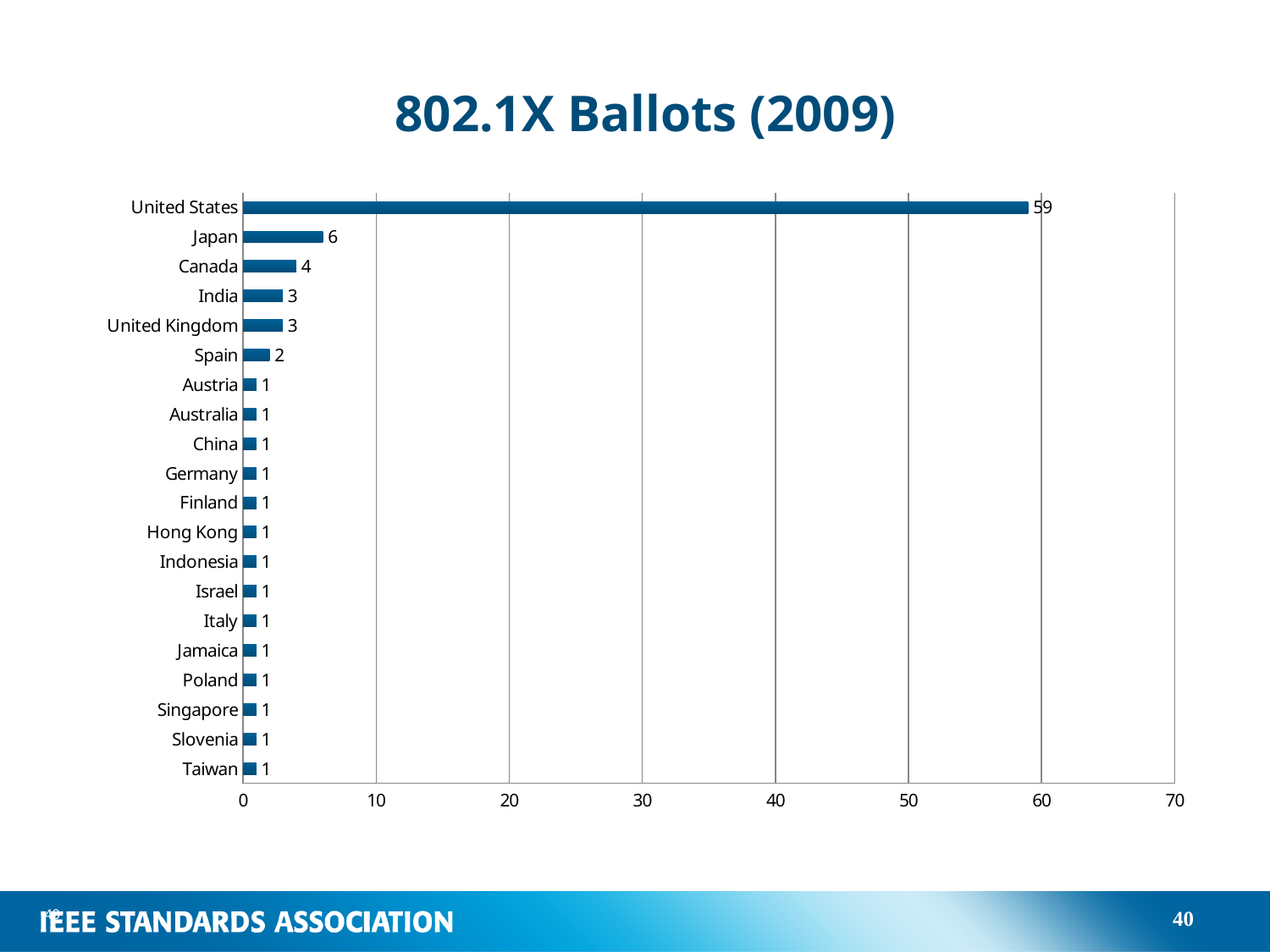
What is the difference between the values for Japan and Canada? 2 What kind of chart is shown on the slide? Bar chart Which is larger, the value for Canada or the value for India? Canada Which country has the highest number of ballots? United States How many countries are shown on the chart? 20 Is the value for the United States greater or less than 50? greater What is the value for the United States? 59 What is the value for Spain? 2 What is the value for Canada? 4 What is the title of the chart? 802.1X Ballots (2009) What is the difference between the values for the United States and Japan? 53 What is the value for Japan? 6